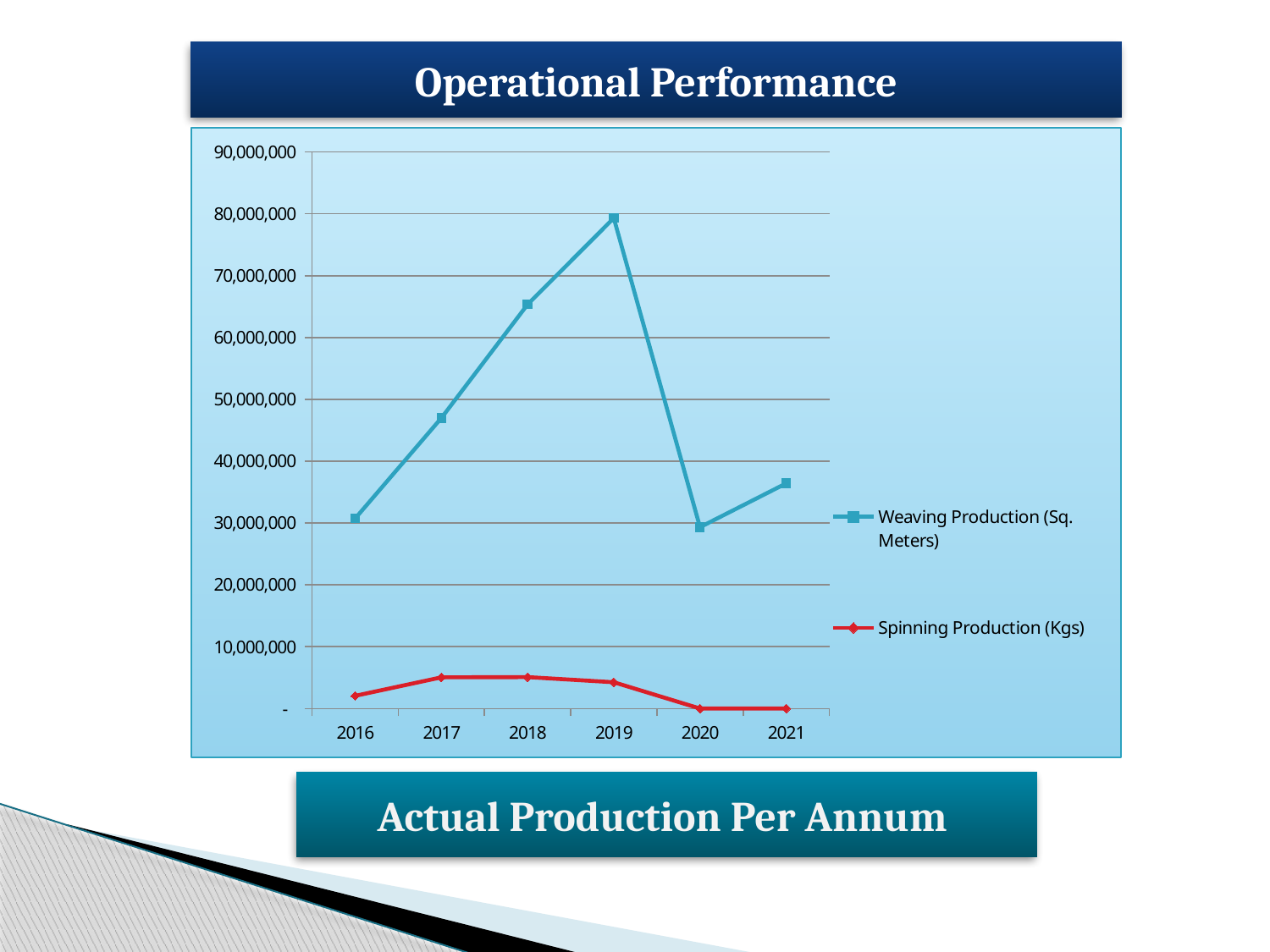
How many years are plotted along the x axis? 6 Does Weaving Production (Sq. Meters) rise or fall from 2016 to 2019? rise In which year is Weaving Production (Sq. Meters) lowest? 2020 Is the Weaving Production (Sq. Meters) value for 2017 greater or less than 50,000,000? less In which year is Weaving Production (Sq. Meters) highest? 2019 Is the Spinning Production (Kgs) value for 2017 greater or less than 10,000,000? less How many series does the legend list? 2 What is the title shown above the chart? Operational Performance What kind of chart is shown on the slide? Line chart Which is larger, Weaving Production (Sq. Meters) in 2018 or in 2017? 2018 Is the Weaving Production (Sq. Meters) value for 2019 greater or less than 70,000,000? greater